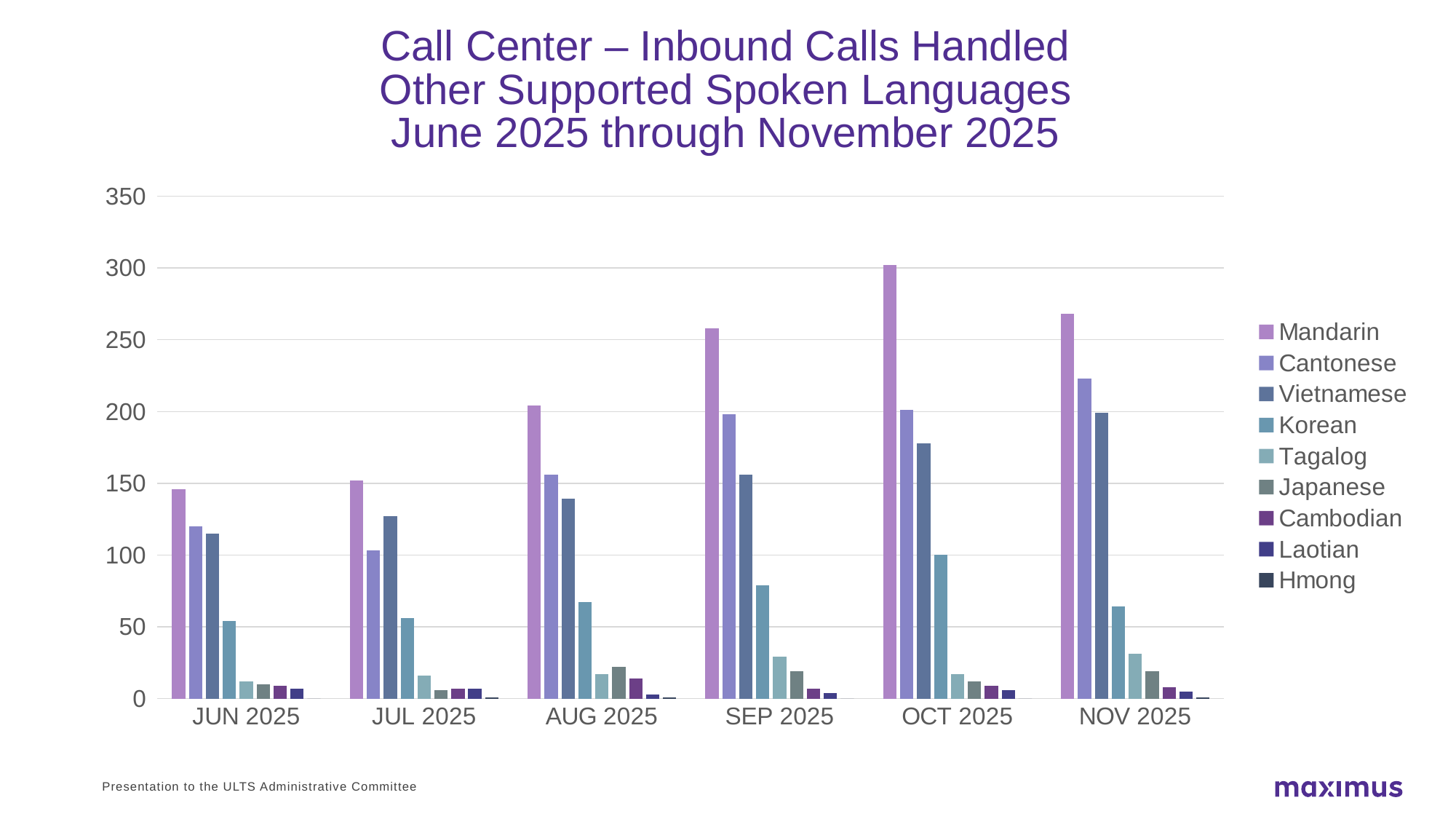
What kind of chart is shown on the slide? bar chart Which language has the lowest bar in every month? Hmong Is the value for Mandarin in OCT 2025 greater or less than 250? greater Is the value for Korean in JUN 2025 greater or less than 100? less Is the value for Cantonese in NOV 2025 greater or less than 200? greater Which language has the highest bar in NOV 2025? Mandarin What period does the chart title say the data covers? June 2025 through November 2025 In JUL 2025, which is larger, Cantonese or Vietnamese? Vietnamese In which month is the Mandarin bar the highest? OCT 2025 Do the Vietnamese values rise or fall from JUN 2025 to NOV 2025? rise How many languages does the legend list? 9 How many months are shown on the x axis? 6